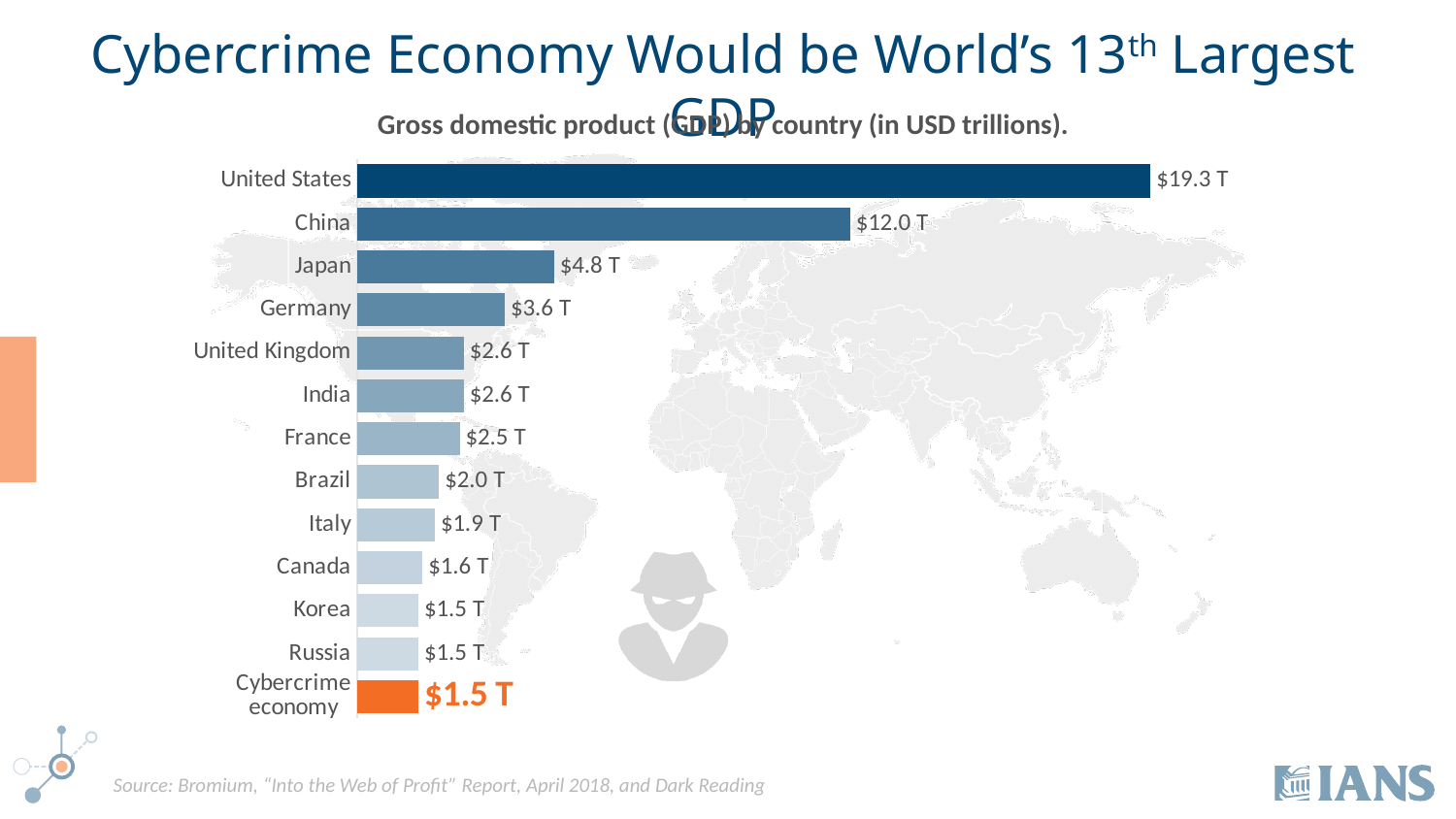
What is the value shown for China? $12.0 T What is the value shown for Germany? $3.6 T What is the value shown for Brazil? $2.0 T What is the difference between the values for Japan and Germany? $1.2 T What is the GDP value shown for the United States? $19.3 T Which category has the highest value in the chart? United States What kind of chart is shown on the slide? Bar chart Which has a larger value, China or Japan? China What is the difference between the values for the United States and China? $7.3 T What is the value shown for the Cybercrime economy bar? $1.5 T Which category's bar is coloured orange? Cybercrime economy How many bars (categories) are shown in the chart? 13